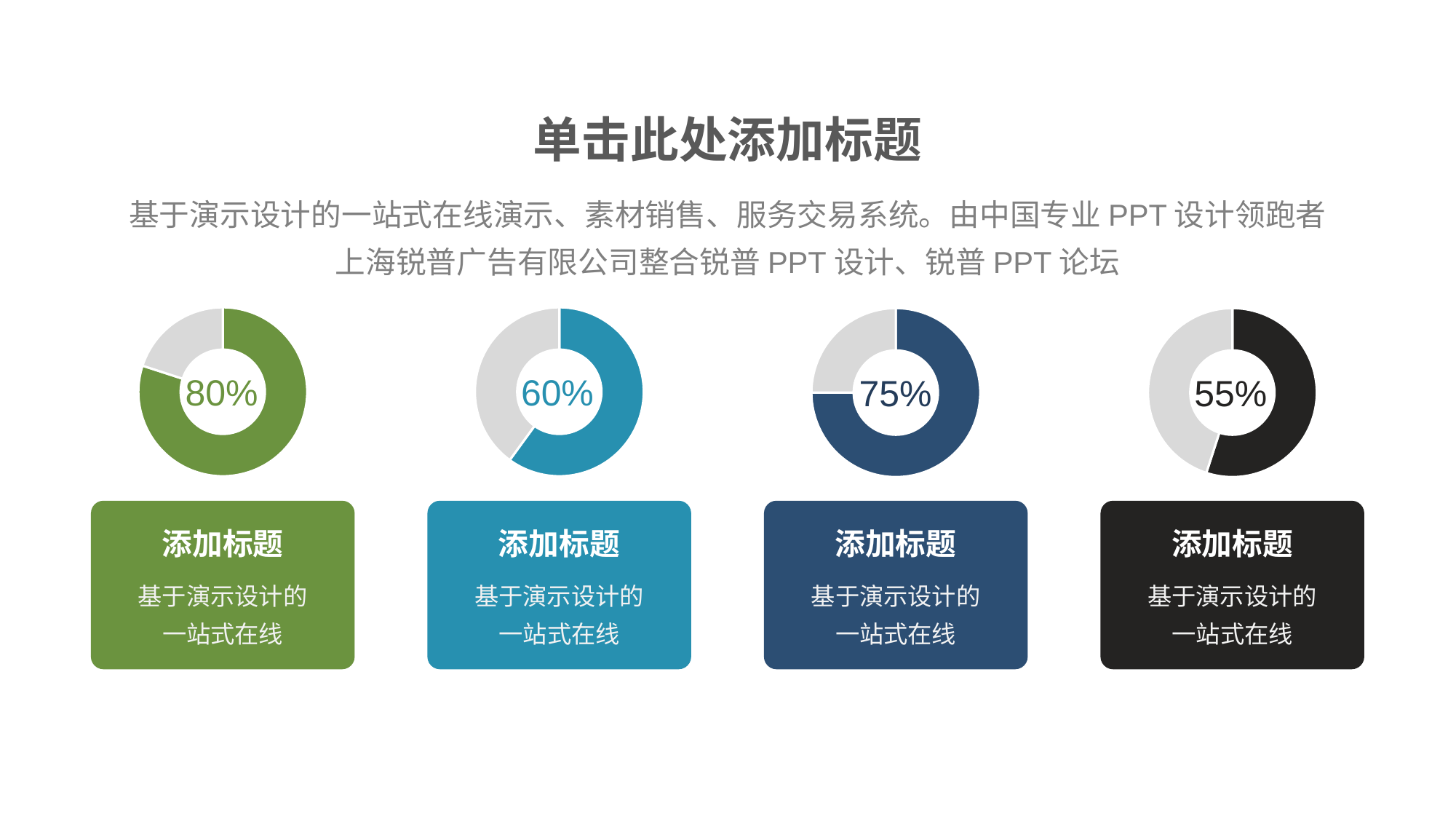
Which of the four donut charts shows the lowest percentage? The rightmost (black) chart, 55% What value is shown in the centre of the second (blue) donut chart from the left? 60% Which of the four donut charts shows the highest percentage? The leftmost (green) chart, 80% How many donut charts are shown on the slide? 4 What colour is the filled portion of the donut chart showing 60%? Blue Which is larger, the value in the second (blue) donut chart or the value in the third (dark blue) donut chart? The third (dark blue) chart, 75% What is the difference between the value in the third (dark blue) donut chart and the value in the second (blue) donut chart? 15% What value is shown in the centre of the leftmost (green) donut chart? 80% What is the difference between the value in the leftmost (green) donut chart and the value in the rightmost (black) donut chart? 25% What kind of chart is used to display the percentages on this slide? Donut chart What value is shown in the centre of the third (dark blue) donut chart from the left? 75% What value is shown in the centre of the rightmost (black) donut chart? 55%